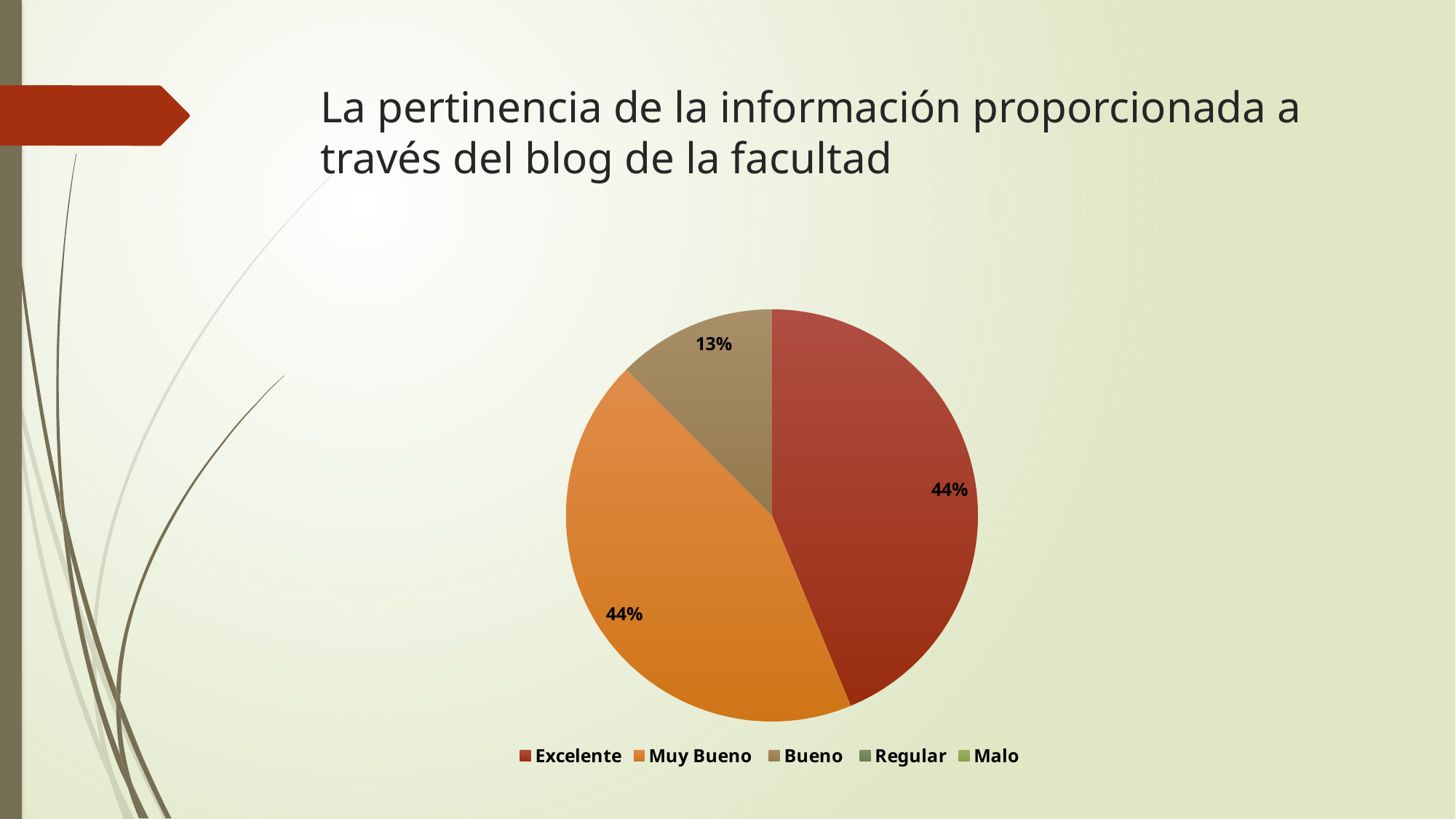
How many slices with a printed percentage are visible in the pie chart? 3 What percentage of the pie chart is labelled Excelente? 44% What is the difference in percentage points between the Excelente slice and the Muy Bueno slice? 0 percentage points Which category has the smallest visible slice in the pie chart? Bueno Which legend entry is shown in dark red in the pie chart? Excelente What percentage of the pie chart is labelled Muy Bueno? 44% What is the difference in percentage points between the Excelente slice and the Bueno slice? 31 percentage points What is the title of the slide containing the pie chart? La pertinencia de la información proporcionada a través del blog de la facultad What type of chart is shown on the slide? Pie chart How many categories does the legend of the pie chart list? 5 What percentage of the pie chart is labelled Bueno? 13% Which is larger in the pie chart, the Excelente slice or the Bueno slice? Excelente